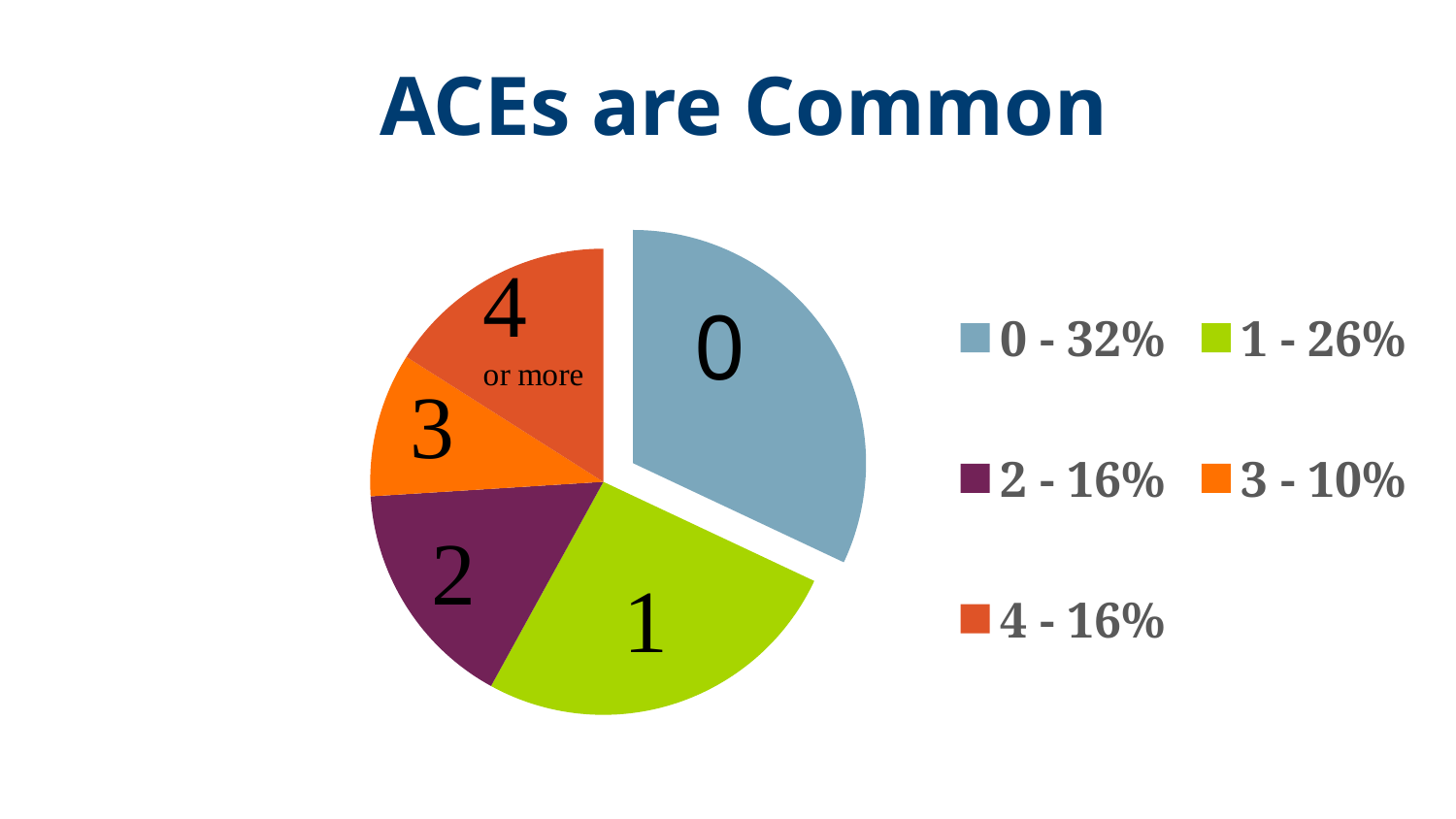
Which slice is larger, '1' or '2'? 1 What percentage is shown for the '1' slice? 26% What percentage is shown for the '0' slice? 32% Which slice has the smallest share of the pie? 3 Which slice has the largest share of the pie? 0 What is the title of the chart? ACEs are Common How many slices does the pie chart have? 5 What percentage is shown for the '3' slice? 10% Which slice is pulled out (exploded) from the rest of the pie? 0 What percentage is shown for the '4 or more' slice? 16% What is the difference in percentage points between the '0' slice and the '1' slice? 6 What kind of chart is shown on the slide? pie chart